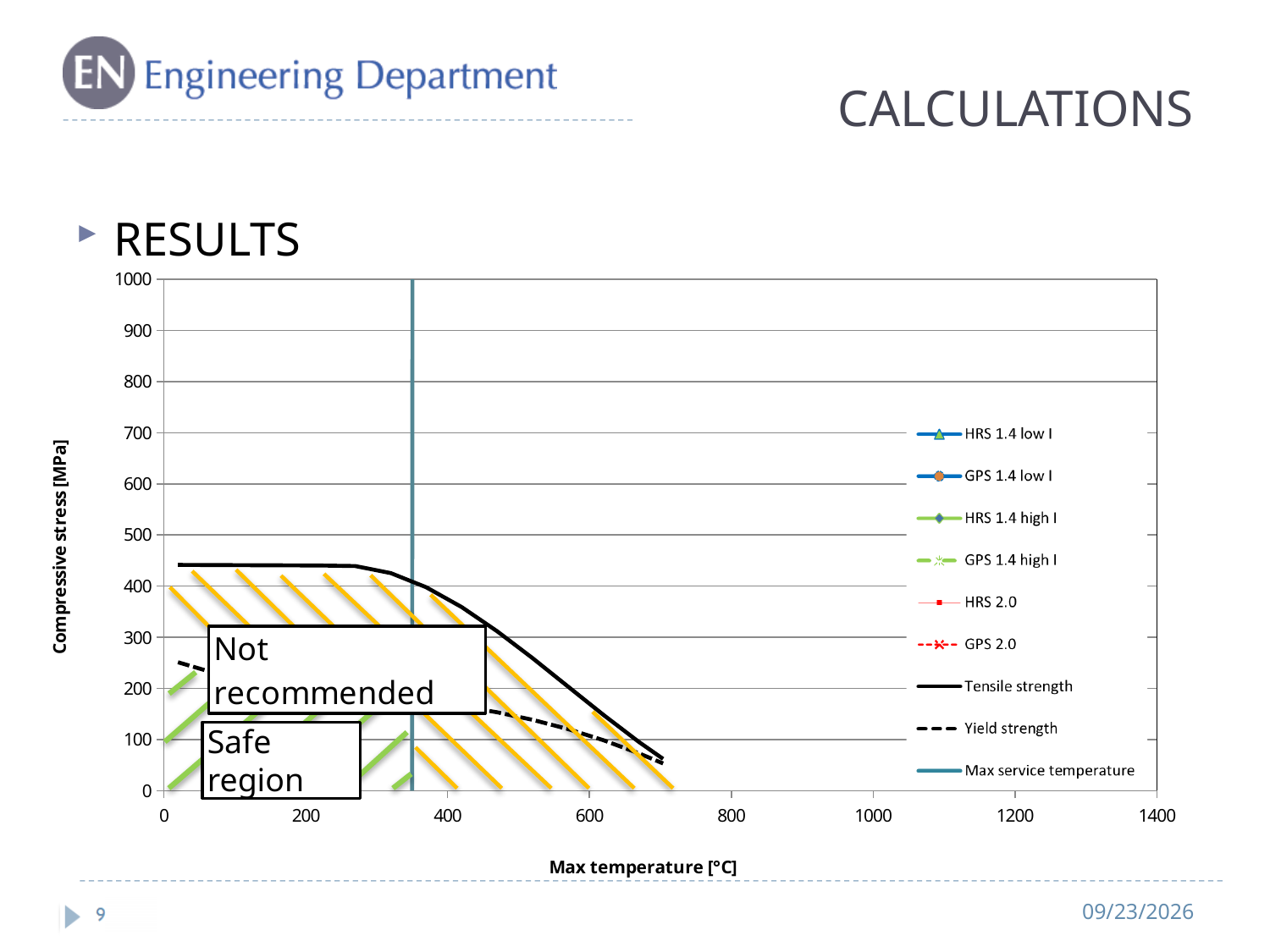
What kind of chart is shown on the slide? line chart Is the Tensile strength value at 200 °C greater or less than 400 MPa? greater How many series does the legend list? 9 Is the Max service temperature line located at a temperature greater or less than 400 °C? less What is the label of the x axis? Max temperature [°C] Is the Tensile strength value at 600 °C greater or less than 200 MPa? less What is the label of the y axis? Compressive stress [MPa] Does the Tensile strength curve rise or fall as the temperature increases beyond 300 °C? fall